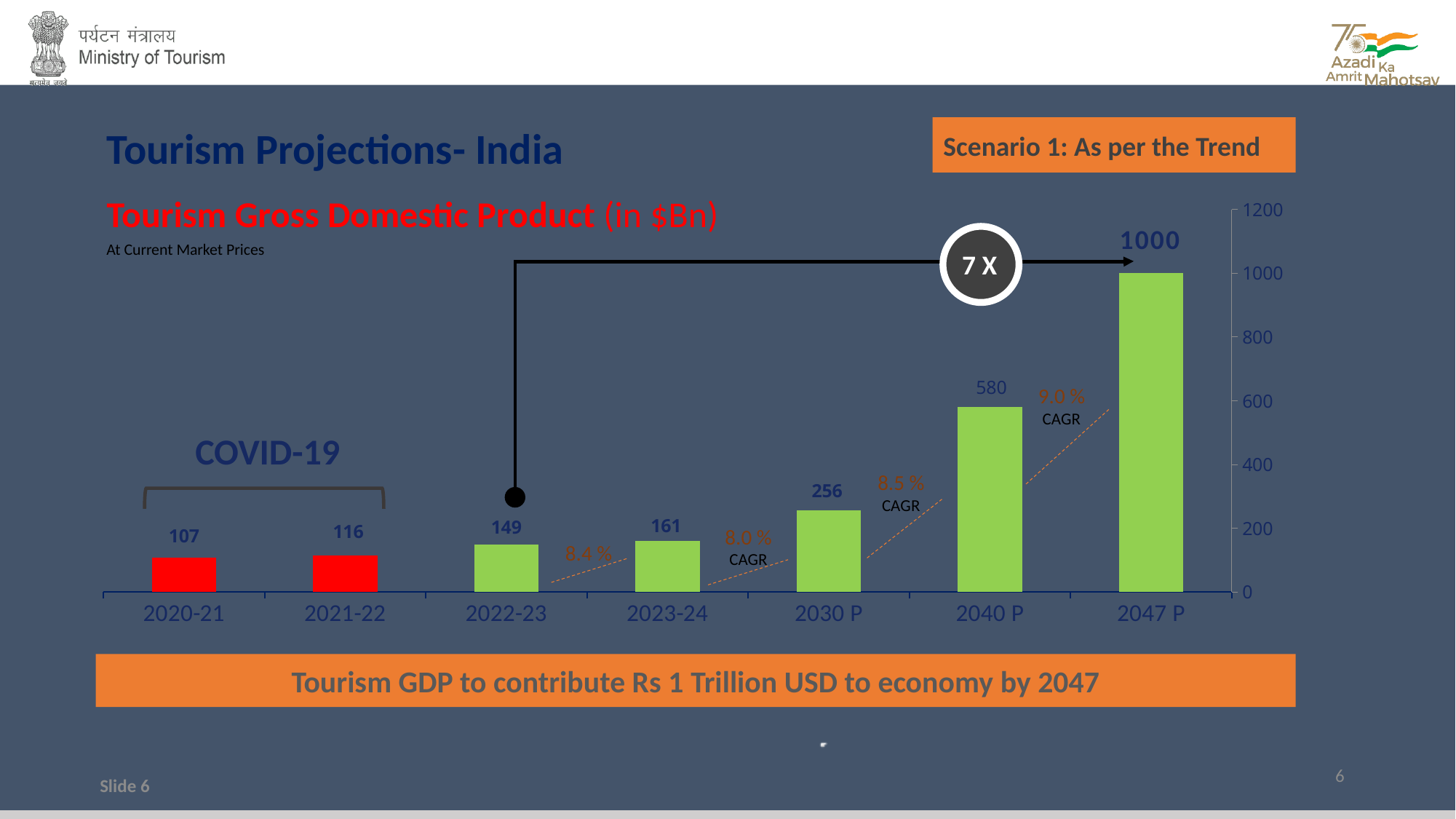
What is the Tourism Gross Domestic Product value for 2020-21? 107 Which category has the highest Tourism Gross Domestic Product value? 2047 P Which category has the lowest Tourism Gross Domestic Product value? 2020-21 Do the Tourism Gross Domestic Product values rise or fall from 2020-21 to 2047 P? Rise What is the difference between the values for 2047 P and 2040 P? 420 What unit is the Tourism Gross Domestic Product chart measured in, according to its title? $Bn What is the projected Tourism Gross Domestic Product value for 2040 P? 580 Which is larger, the value for 2021-22 or the value for 2022-23? 2022-23 What is the difference between the values for 2030 P and 2023-24? 95 What kind of chart is shown on the slide? Bar chart What is the Tourism Gross Domestic Product value for 2023-24? 161 How many categories are shown on the x axis of the chart? 7